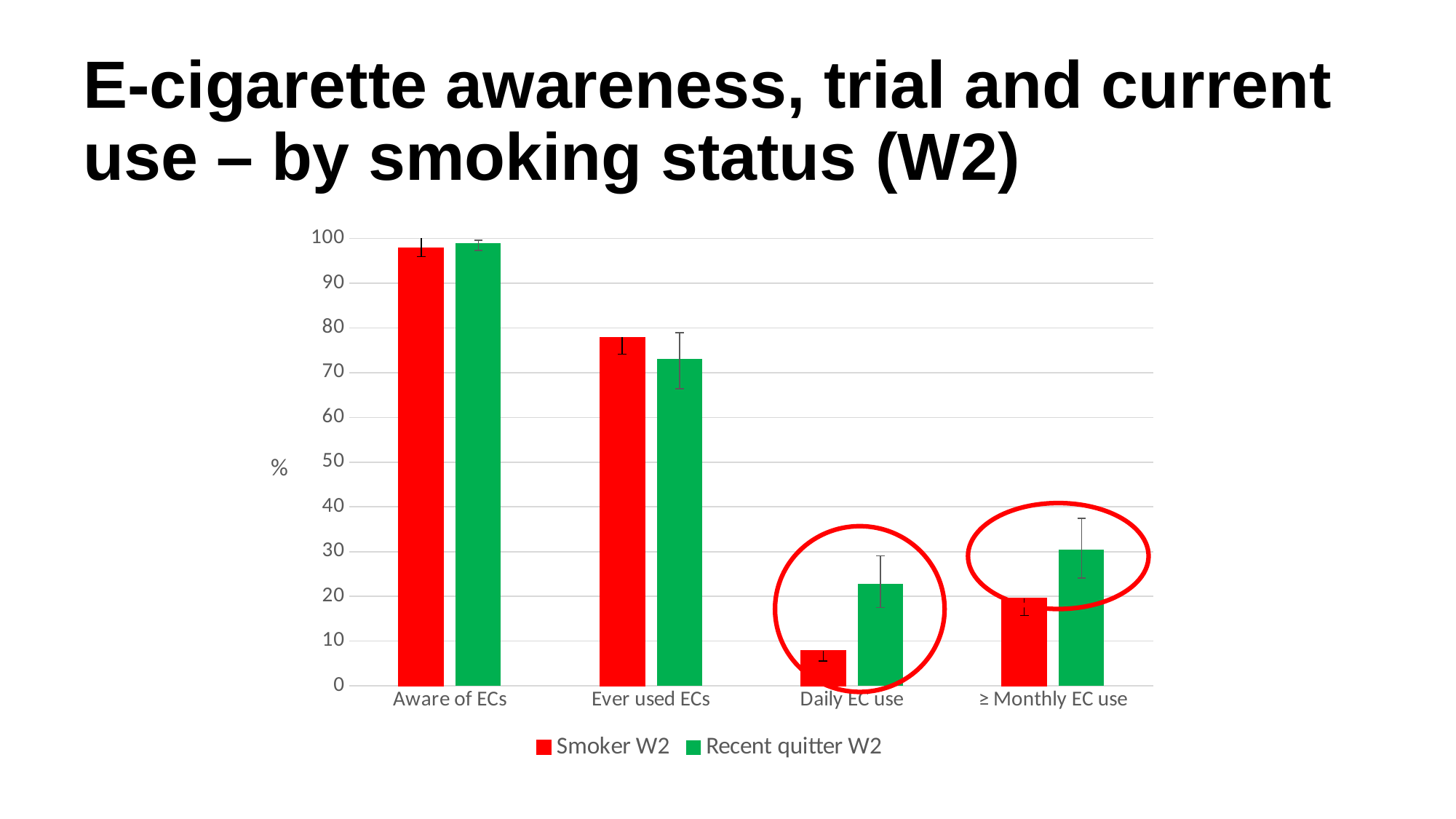
For Daily EC use, which series has the larger value, Smoker W2 or Recent quitter W2? Recent quitter W2 For Ever used ECs, which series has the larger value, Smoker W2 or Recent quitter W2? Smoker W2 How many series does the chart's legend list? 2 Which category has the highest value for the Recent quitter W2 series? Aware of ECs Is the Smoker W2 value for Ever used ECs greater or less than 70? greater How many categories are shown on the x axis of the chart? 4 What kind of chart is shown on the slide? bar chart Is the Smoker W2 value for Daily EC use greater or less than 10? less Which category has the lowest value for the Smoker W2 series? Daily EC use What label is shown on the vertical axis of the chart? % Is the Recent quitter W2 value for ≥ Monthly EC use greater or less than 20? greater What colour are the bars for the Smoker W2 series? red